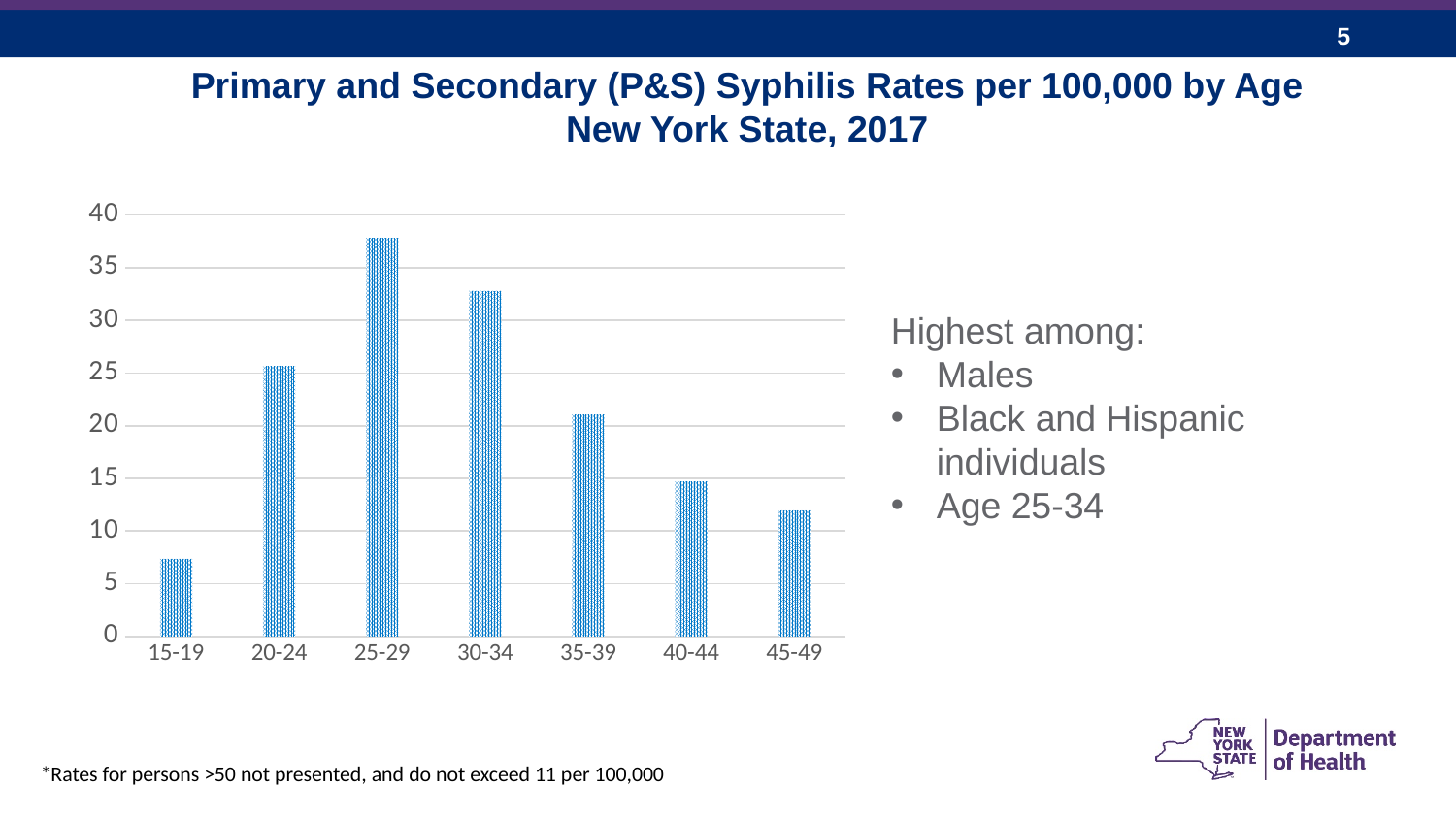
Is the value for the 15-19 age group greater or less than 10? less Is the value for the 25-29 age group greater or less than 35? greater What is the title of the chart on the slide? Primary and Secondary (P&S) Syphilis Rates per 100,000 by Age New York State, 2017 What type of chart is shown on the slide? bar chart Is the value for the 30-34 age group greater or less than 30? greater Which age group has the lowest P&S syphilis rate? 15-19 Which age group has a higher rate, 30-34 or 45-49? 30-34 How many age groups are shown on the x axis of the chart? 7 Do the rates rise or fall from the 25-29 age group to the 45-49 age group? fall Which age group has the highest P&S syphilis rate? 25-29 Which age group has a higher rate, 20-24 or 35-39? 20-24